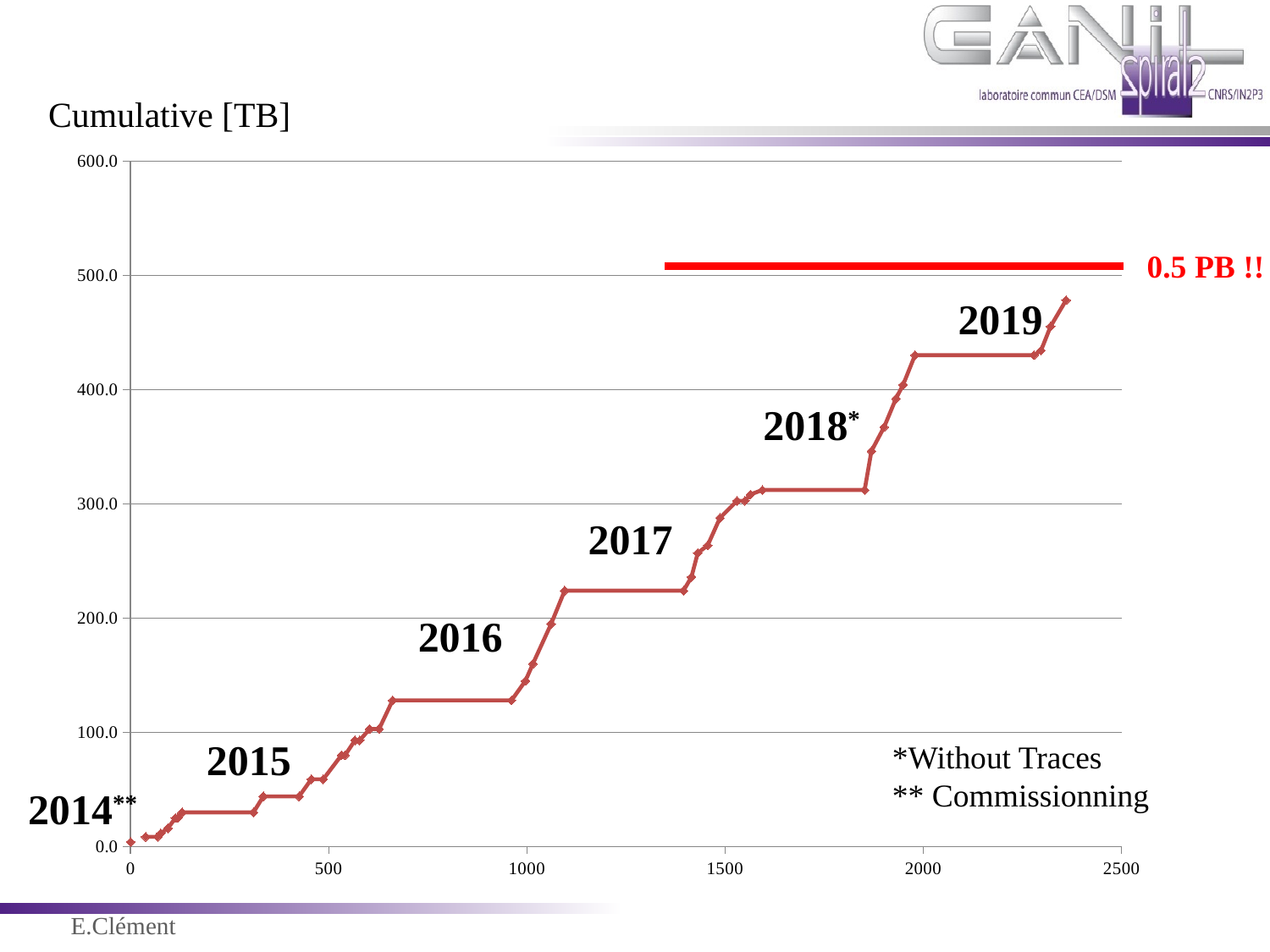
What is the title of the chart? Cumulative [TB] Is the plateau value reached after the 2017 rise greater or less than 200? greater Is the plateau value reached after the 2019 rise greater or less than 500? less Is the plateau value reached after the 2018 rise greater or less than 300? greater How many year labels are annotated along the plotted line? 6 What is the highest value shown on the y axis? 600.0 Do the plotted values rise or fall along the x axis? rise What kind of chart is shown on the slide? line chart